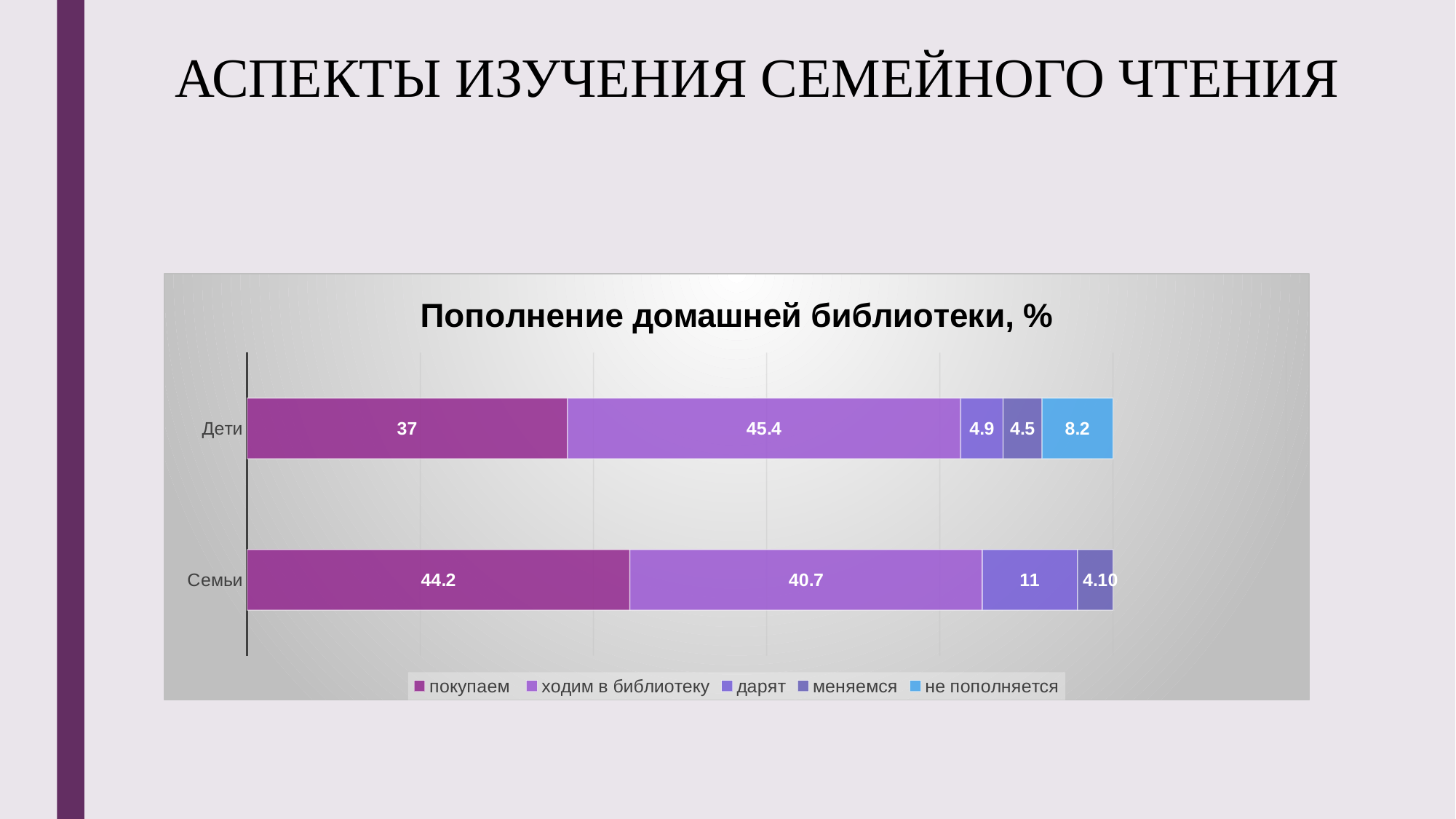
What is the value of "покупаем" for Дети? 37 What kind of chart is shown? Stacked bar chart How many series does the legend list? 5 What is the value of "не пополняется" for Дети? 8.2 What is the value of "меняемся" for Дети? 4.5 Which category has the larger value for "ходим в библиотеку", Дети or Семьи? Дети What is the difference between the "покупаем" values for Семьи and Дети? 7.2 What is the value of "ходим в библиотеку" for Семьи? 40.7 What is the value of "дарят" for Семьи? 11 What is the title of the chart? Пополнение домашней библиотеки, % How many categories are shown on the vertical axis? 2 Which category has the larger value for "дарят", Дети or Семьи? Семьи